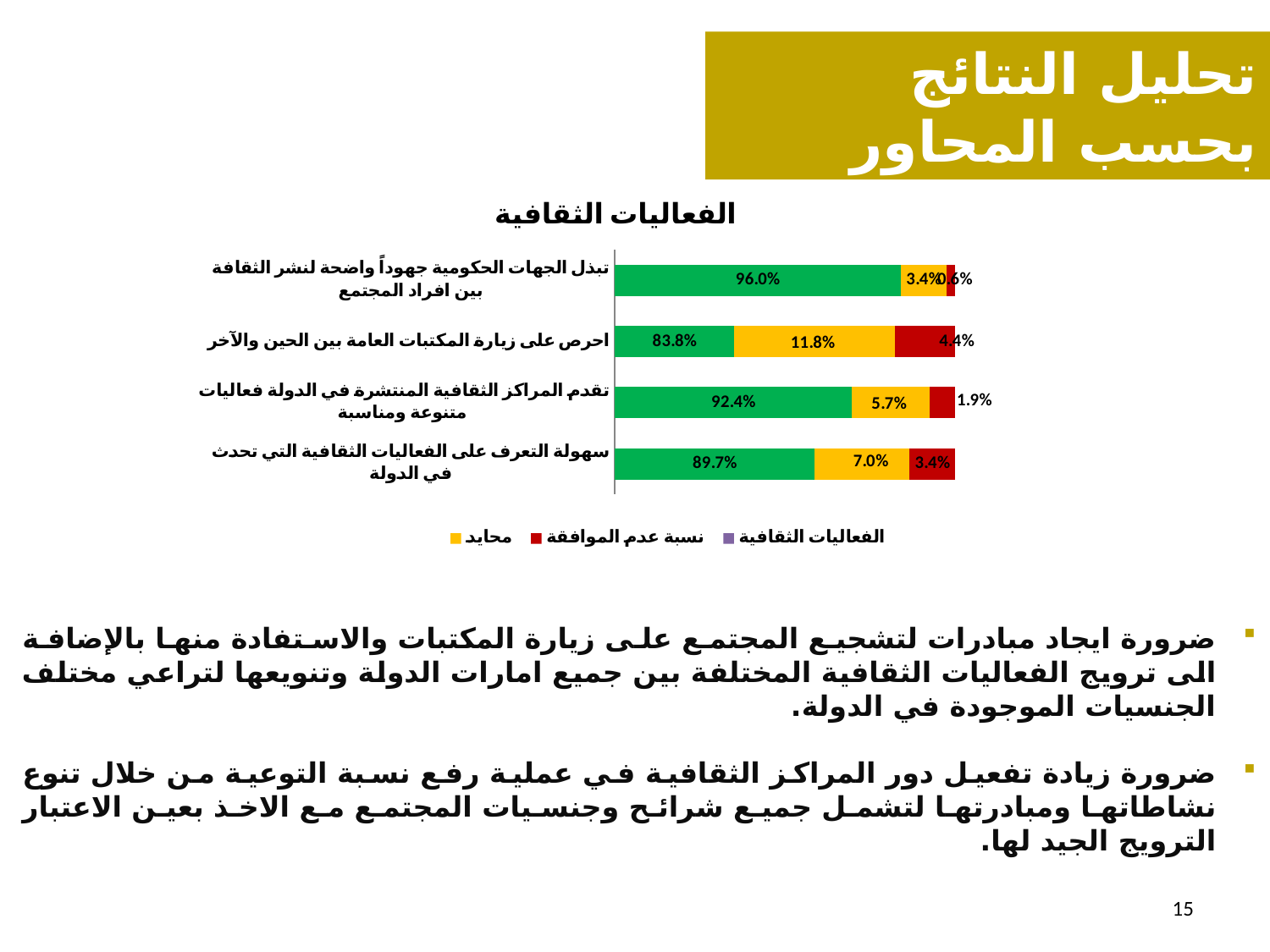
What is the difference between the green segment values of 'تبذل الجهات الحكومية جهوداً واضحة لنشر الثقافة بين افراد المجتمع' and 'احرص على زيارة المكتبات العامة بين الحين والآخر'? 12.2% What type of chart is shown on the slide? Stacked bar chart How many categories (statements) are plotted in the chart? 4 What is the value of the red (نسبة عدم الموافقة) segment for 'تقدم المراكز الثقافية المنتشرة في الدولة فعاليات متنوعة ومناسبة'? 1.9% What is the title of the chart? الفعاليات الثقافية Which category has the highest green segment value? تبذل الجهات الحكومية جهوداً واضحة لنشر الثقافة بين افراد المجتمع Which category has the lowest green segment value? احرص على زيارة المكتبات العامة بين الحين والآخر What is the value of the yellow (محايد) segment for 'سهولة التعرف على الفعاليات الثقافية التي تحدث في الدولة'? 7.0% Which is larger: the yellow (محايد) value for 'احرص على زيارة المكتبات العامة بين الحين والآخر' or for 'تقدم المراكز الثقافية المنتشرة في الدولة فعاليات متنوعة ومناسبة'? احرص على زيارة المكتبات العامة بين الحين والآخر How many series does the chart legend list? 3 What is the total of the three segments for 'تبذل الجهات الحكومية جهوداً واضحة لنشر الثقافة بين افراد المجتمع'? 100.0% What is the value of the green segment for 'احرص على زيارة المكتبات العامة بين الحين والآخر'? 83.8%